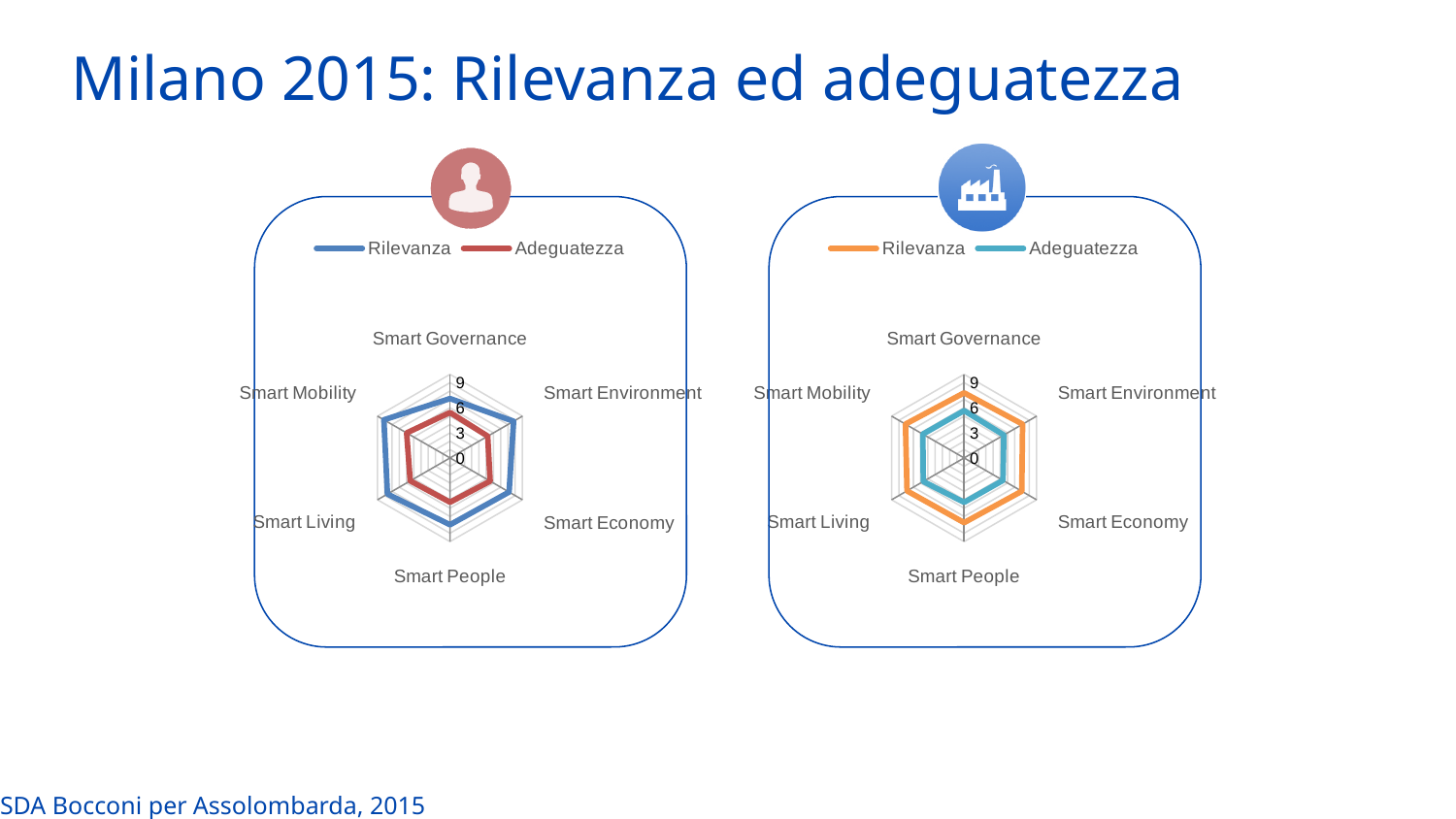
What are the two legend entries of the left chart? Rilevanza and Adeguatezza How many series does the legend of the right chart list? 2 How many categories (axes) does the left chart have? 6 In the left chart, is the Rilevanza value for Smart Governance greater or less than 6? greater What kind of chart is the left chart on the slide? Radar chart In the left chart, is the Adeguatezza value for Smart People greater or less than 3? greater In the right chart, which series has the larger value for Smart Environment, Rilevanza or Adeguatezza? Rilevanza In the right chart, is the Adeguatezza value for Smart Economy greater or less than 6? less In the left chart, which series has the larger value for Smart Mobility, Rilevanza or Adeguatezza? Rilevanza What colour is the Rilevanza series in the right chart? Orange